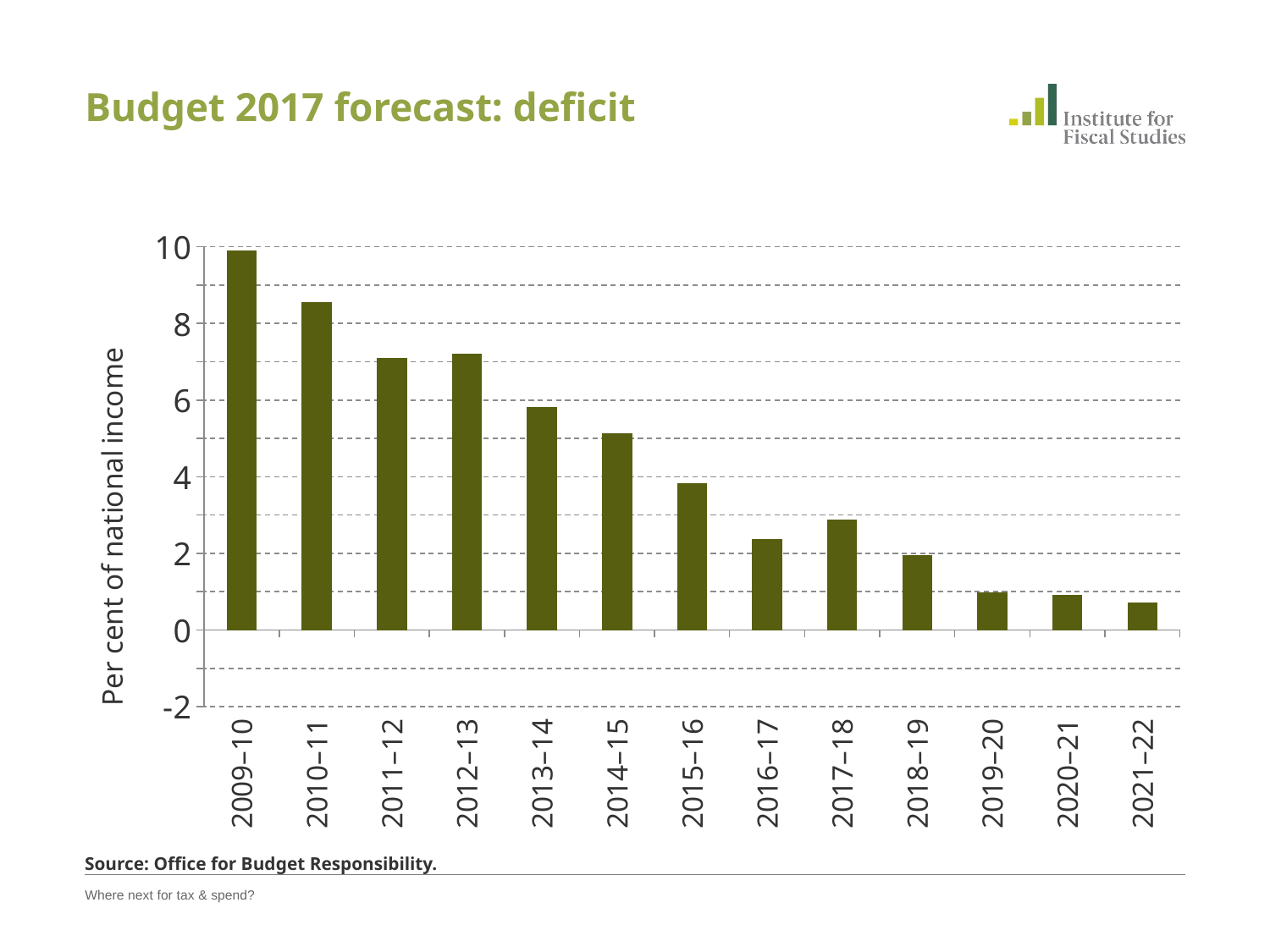
Which is larger, the value for 2010–11 or the value for 2013–14? 2010–11 Is the value for 2013–14 greater or less than 6? less Is the value for 2009–10 greater or less than 8? greater Which year has the highest deficit? 2009–10 Which is larger, the value for 2016–17 or the value for 2017–18? 2017–18 How many fiscal years are shown on the x axis? 13 Is the value for 2014–15 greater or less than 4? greater Do the values generally rise or fall from 2009–10 to 2021–22? Fall What kind of chart is shown on the slide? Bar chart What is the label on the vertical axis? Per cent of national income